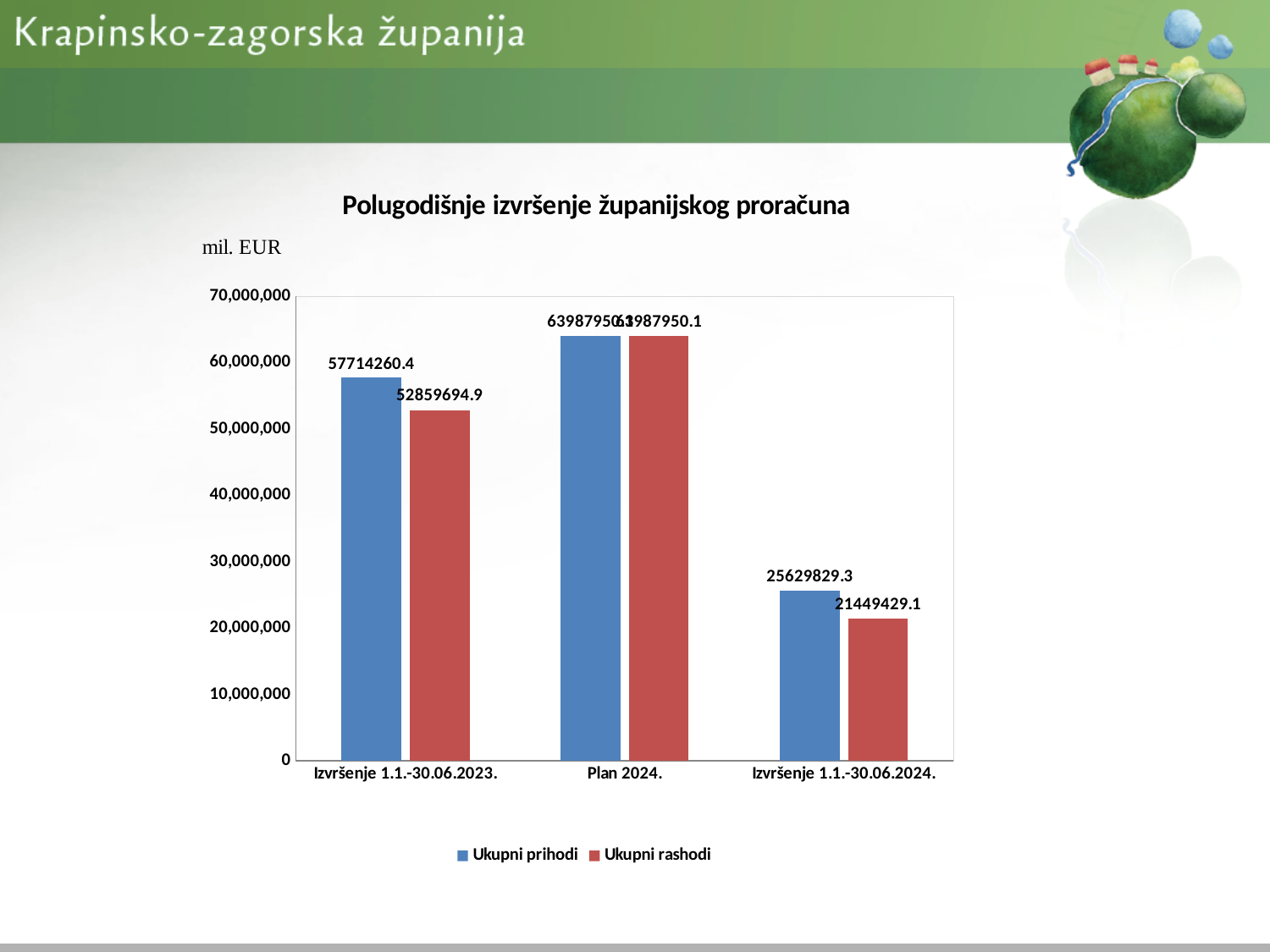
What is the value of Ukupni prihodi for Izvršenje 1.1.-30.06.2023.? 57714260.4 What kind of chart is shown on the slide? bar chart Which category has the highest value for Ukupni prihodi? Plan 2024. How many series does the legend list? 2 What is the value of Ukupni rashodi for Izvršenje 1.1.-30.06.2023.? 52859694.9 What is the value of Ukupni prihodi for Izvršenje 1.1.-30.06.2024.? 25629829.3 What is the difference between Ukupni prihodi and Ukupni rashodi for Izvršenje 1.1.-30.06.2023.? 4854565.5 For Izvršenje 1.1.-30.06.2024., which is larger: Ukupni prihodi or Ukupni rashodi? Ukupni prihodi What is the value of Ukupni rashodi for Izvršenje 1.1.-30.06.2024.? 21449429.1 Which category has the lowest value for Ukupni rashodi? Izvršenje 1.1.-30.06.2024. How many categories are shown on the x axis? 3 What is the title of the chart? Polugodišnje izvršenje županijskog proračuna